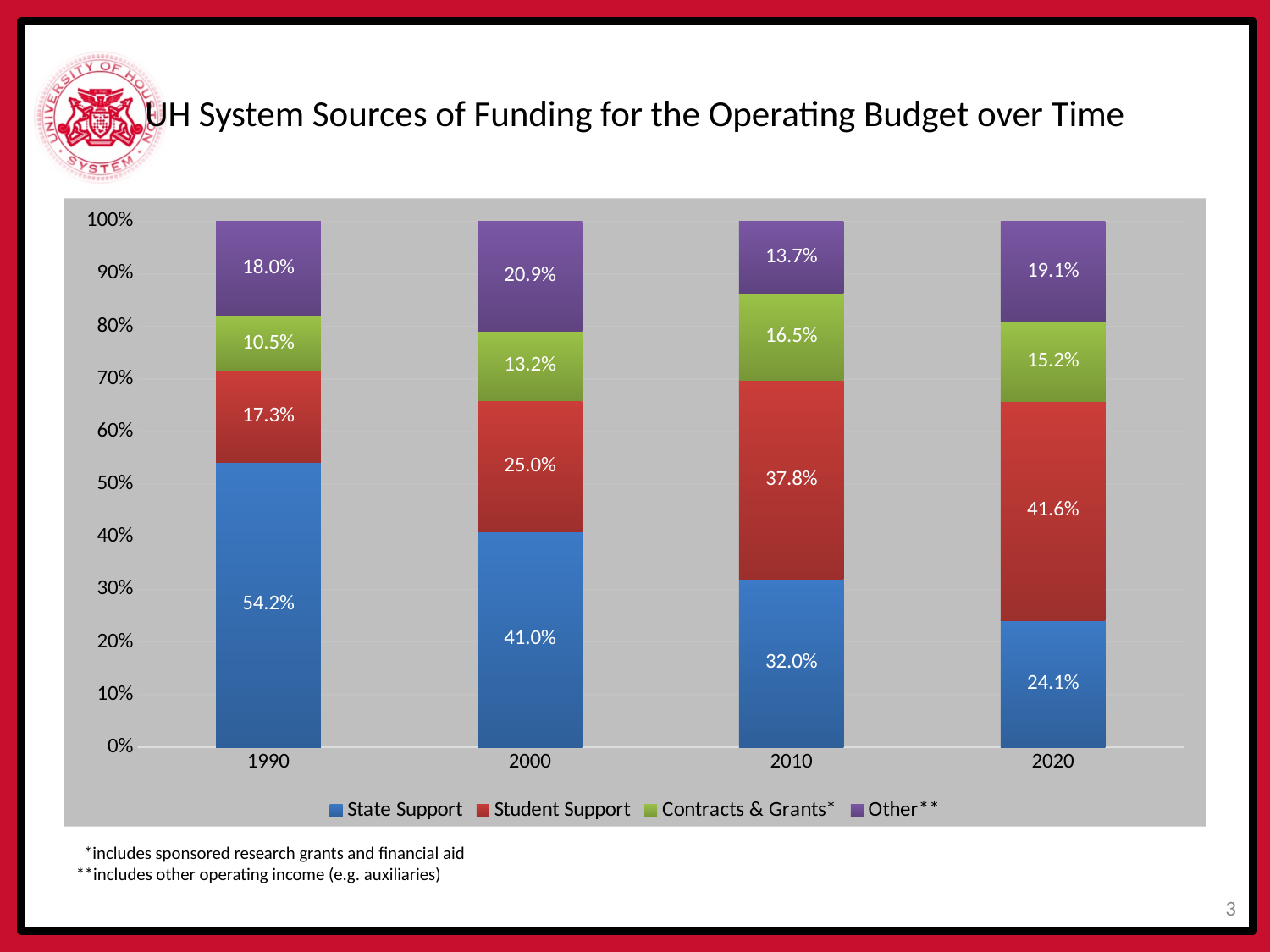
What is the State Support share in 1990? 54.2% What is the Contracts & Grants* share in 2010? 16.5% Does the State Support share rise or fall from 1990 to 2020? Fall What kind of chart is shown? Stacked bar chart In which year is the Other** share lowest? 2010 What is the Other** share in 2000? 20.9% How many series does the legend list? 4 What is the Student Support share in 2020? 41.6% What is the difference between the State Support share in 1990 and in 2020? 30.1% In which year is the State Support share highest? 1990 How many years are shown on the x axis? 4 Which is larger in 2010: State Support or Student Support? Student Support